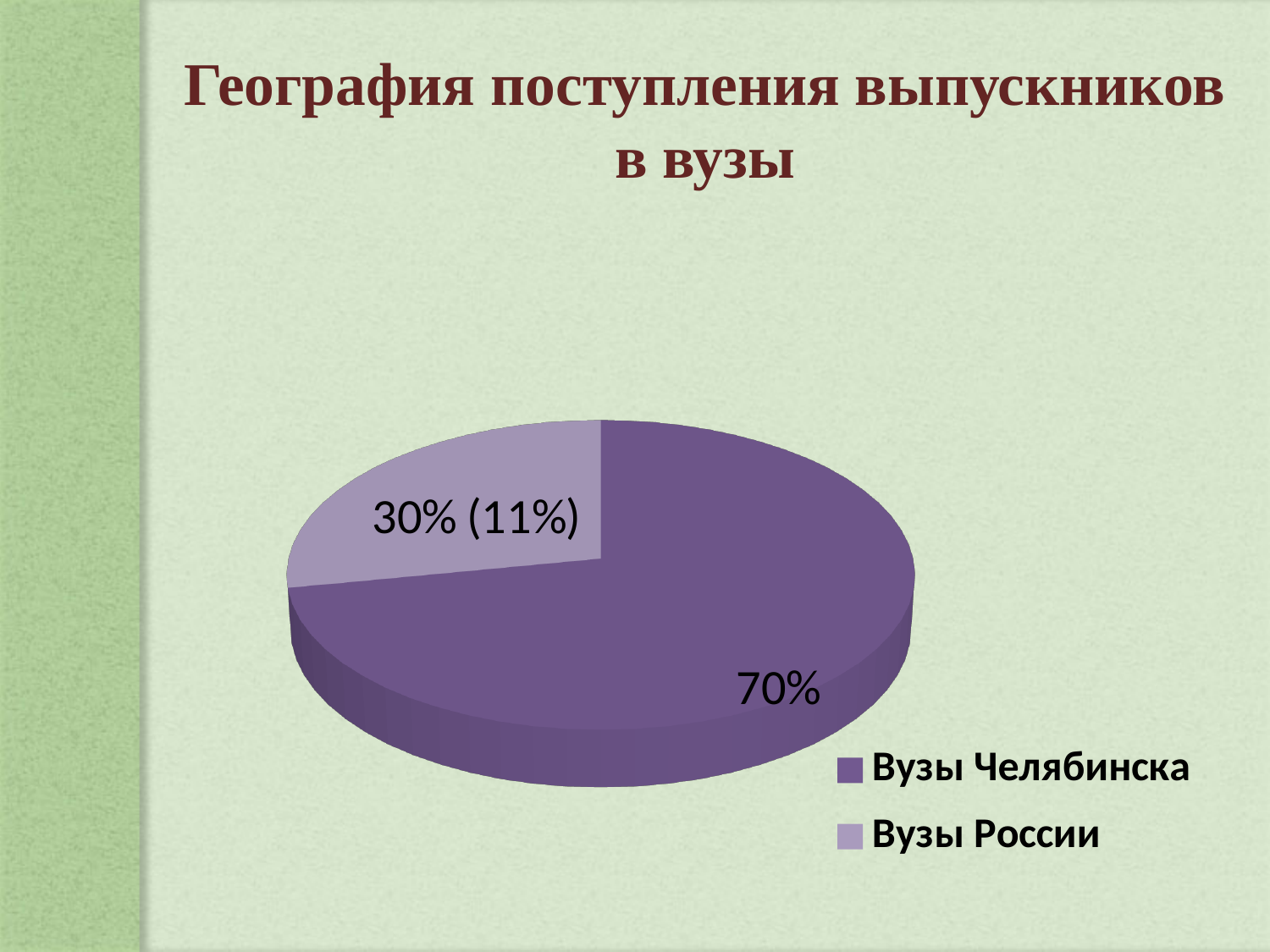
What share of the pie is labelled for Вузы Челябинска? 70% Which is larger, the Вузы Челябинска slice or the Вузы России slice? Вузы Челябинска What label is printed on the Вузы России slice? 30% (11%) How many entries does the legend list? 2 What kind of chart is shown on the slide? pie chart What is the title of the slide? География поступления выпускников в вузы What is the difference in percentage points between the Вузы Челябинска slice (70%) and the Вузы России slice (30%)? 40% Which slice is the largest? Вузы Челябинска How many slices does the pie chart have? 2 Which legend entry is shown in the lighter purple colour? Вузы России Which slice is the smallest? Вузы России